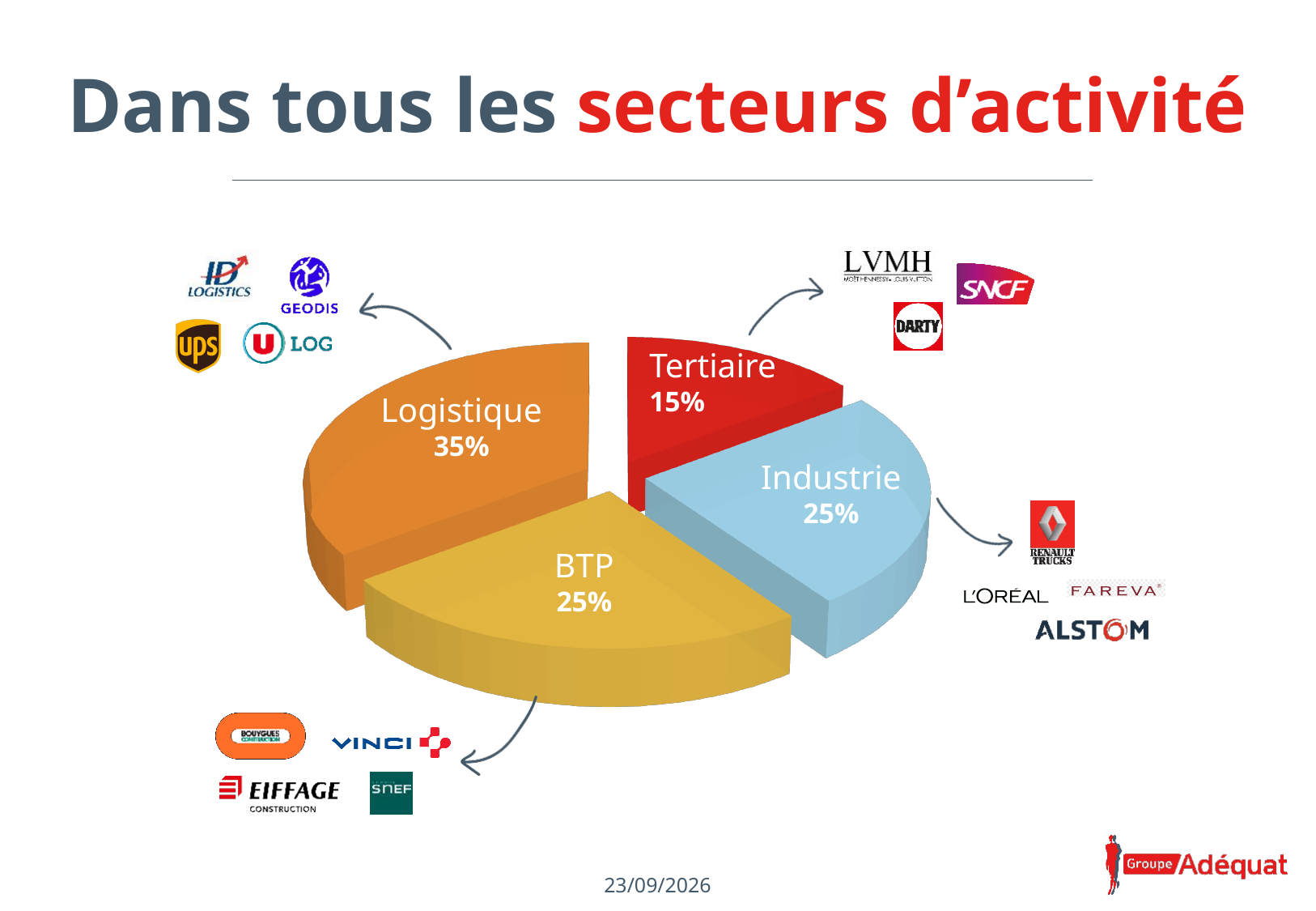
Which sector has the smallest share of the pie? Tertiaire What percentage is shown for Tertiaire? 15% Which sector has the largest share of the pie? Logistique What percentage is shown for Industrie? 25% How many slices does the pie chart have? 4 What is the difference in percentage points between Logistique and Tertiaire? 20 What percentage is shown for BTP? 25% What kind of chart is shown on the slide? pie chart What colour is the Tertiaire slice? red What colour is the Logistique slice? orange Which is larger, the share for Logistique or the share for Industrie? Logistique What percentage is shown for Logistique? 35%